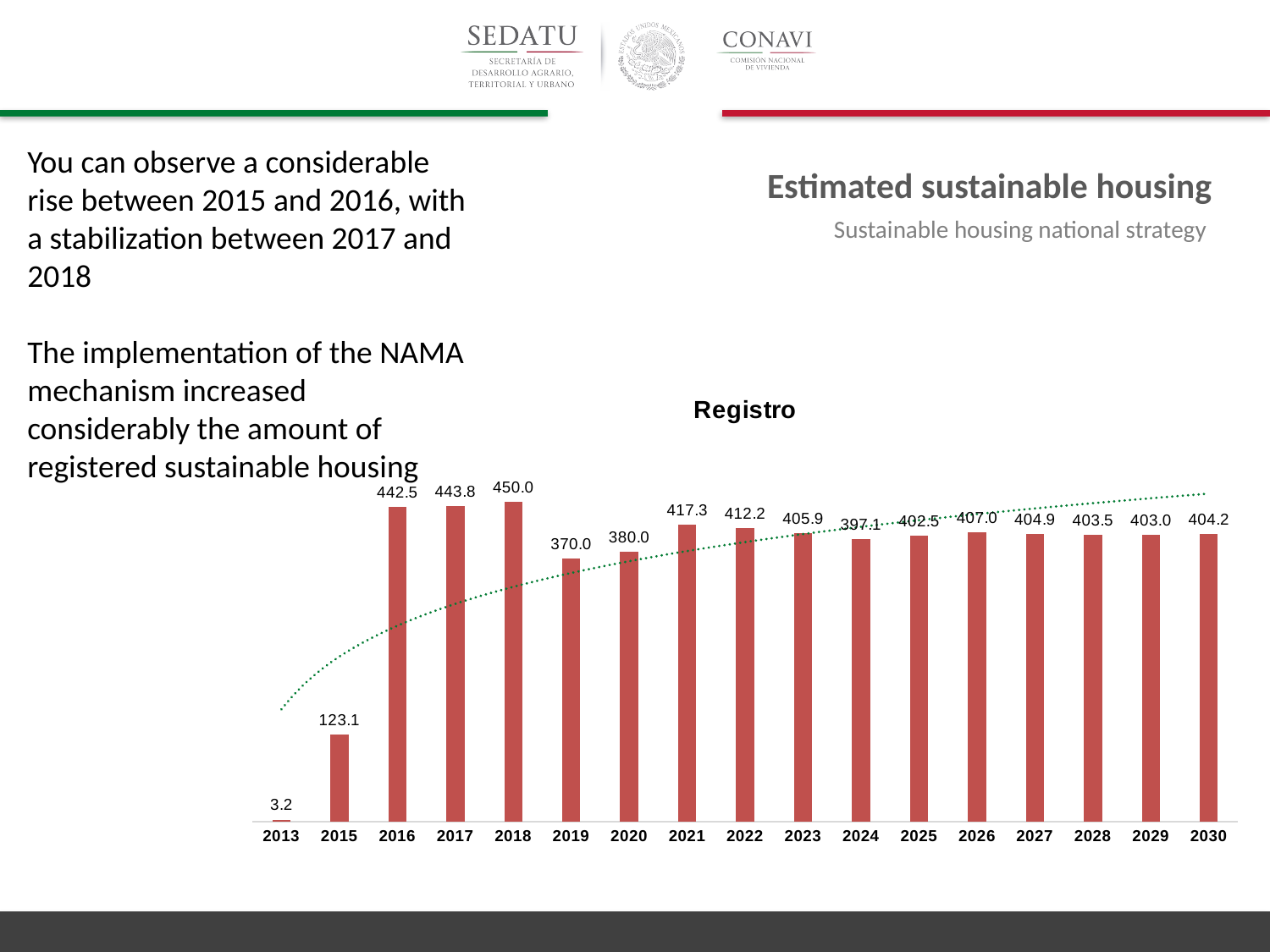
Do the values in the Registro chart rise or fall from 2013 to 2018? Rise What kind of chart is the Registro chart? Bar chart How many years are shown on the x axis of the Registro chart? 17 What is the difference between the values for 2018 and 2019 in the Registro chart? 80.0 What is the difference between the values for 2016 and 2015 in the Registro chart? 319.4 Which year has the lowest value in the Registro chart? 2013 Which year has the larger value in the Registro chart, 2019 or 2020? 2020 What is the value for 2024 in the Registro chart? 397.1 What is the title of the chart on the slide? Registro What is the value for 2016 in the Registro chart? 442.5 Which year has the highest value in the Registro chart? 2018 What is the value for 2013 in the Registro chart? 3.2